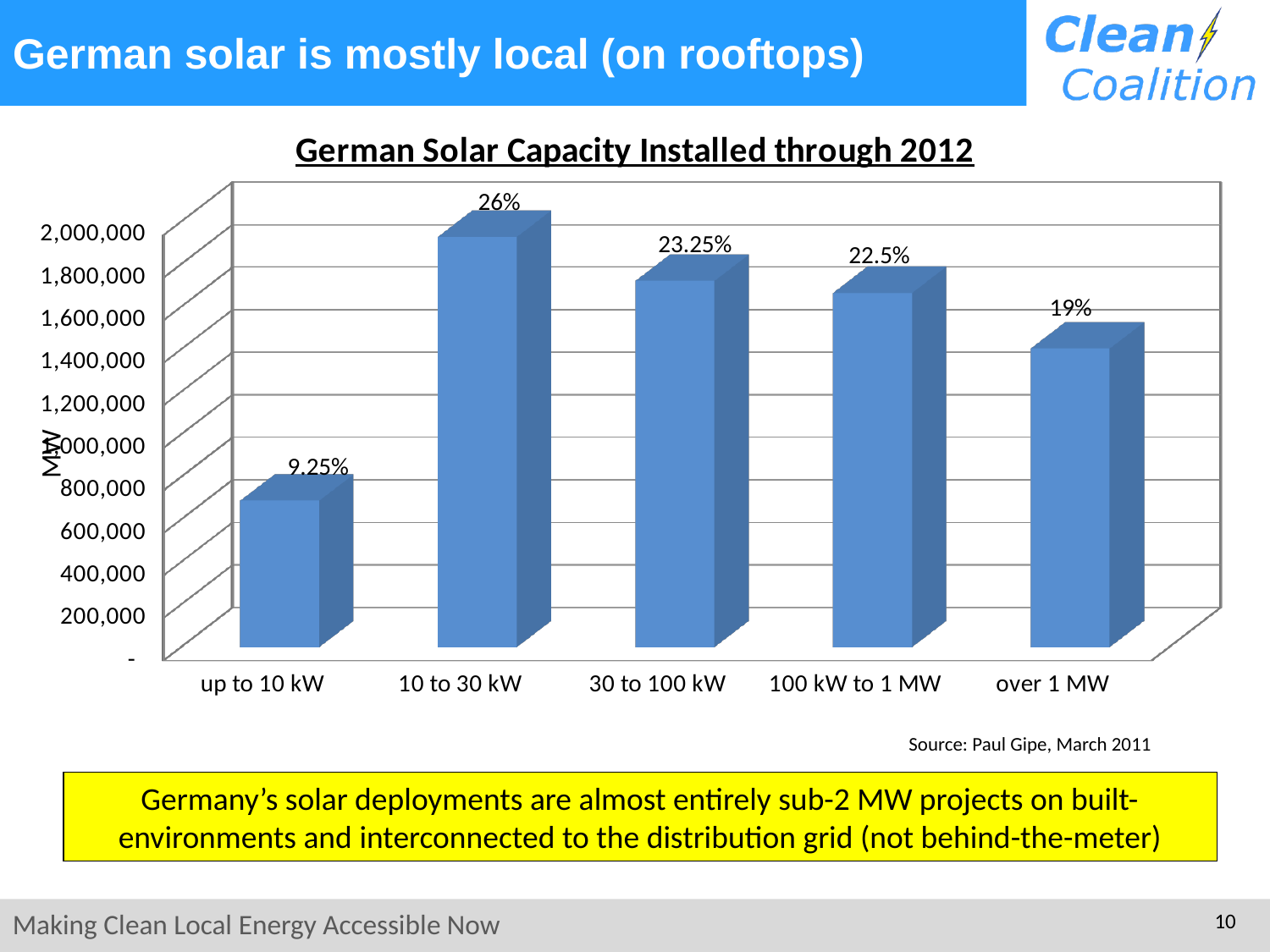
What is the title of the chart? German Solar Capacity Installed through 2012 How many categories are shown on the x axis? 5 What is the data label shown on the bar for '10 to 30 kW'? 26% What is the data label shown on the bar for 'up to 10 kW'? 9.25% Which category has the tallest bar? 10 to 30 kW What is the data label shown on the bar for 'over 1 MW'? 19% Which category has the shortest bar? up to 10 kW Is the value for 'up to 10 kW' greater or less than 1,000,000 MW? less What is the data label shown on the bar for '30 to 100 kW'? 23.25% What is the data label shown on the bar for '100 kW to 1 MW'? 22.5% Which has a larger value, '30 to 100 kW' or 'up to 10 kW'? 30 to 100 kW What is the difference between the percentage labels for '10 to 30 kW' and 'over 1 MW'? 7%